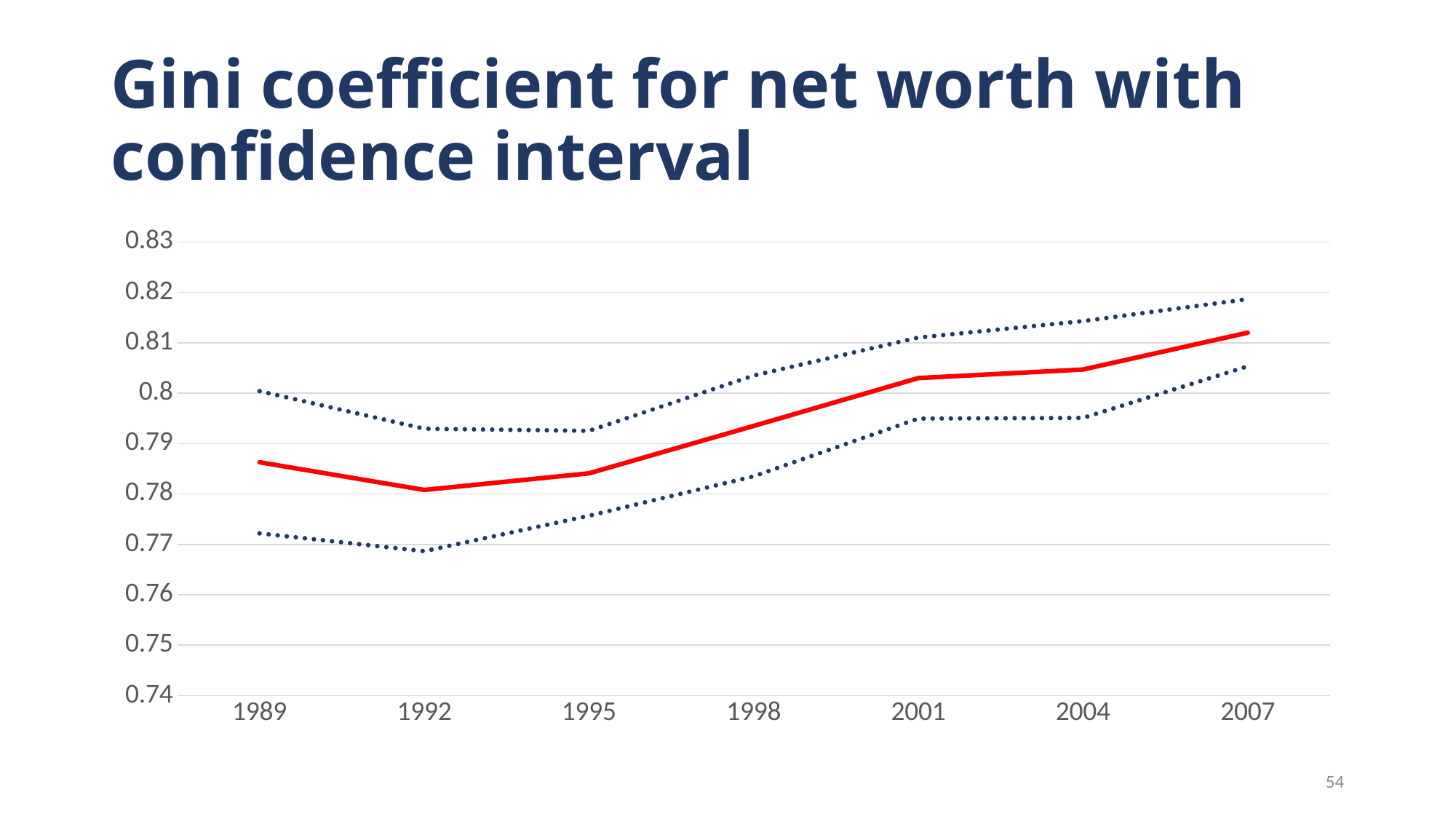
Which is larger for the solid red line: the value in 2001 or the value in 1989? 2001 Is the value of the solid red line in 1995 greater or less than 0.79? less Does the solid red line generally rise or fall between 1992 and 2007? rise How many lines are plotted on the chart? 3 What kind of chart is shown on the slide? line chart What is the title of the chart on the slide? Gini coefficient for net worth with confidence interval In which year does the solid red line reach its lowest value? 1992 Is the value of the solid red line in 1989 greater or less than 0.78? greater Is the value of the upper dotted line in 2007 greater or less than 0.81? greater In which year does the solid red line reach its highest value? 2007 How many years are marked on the x axis of the chart? 7